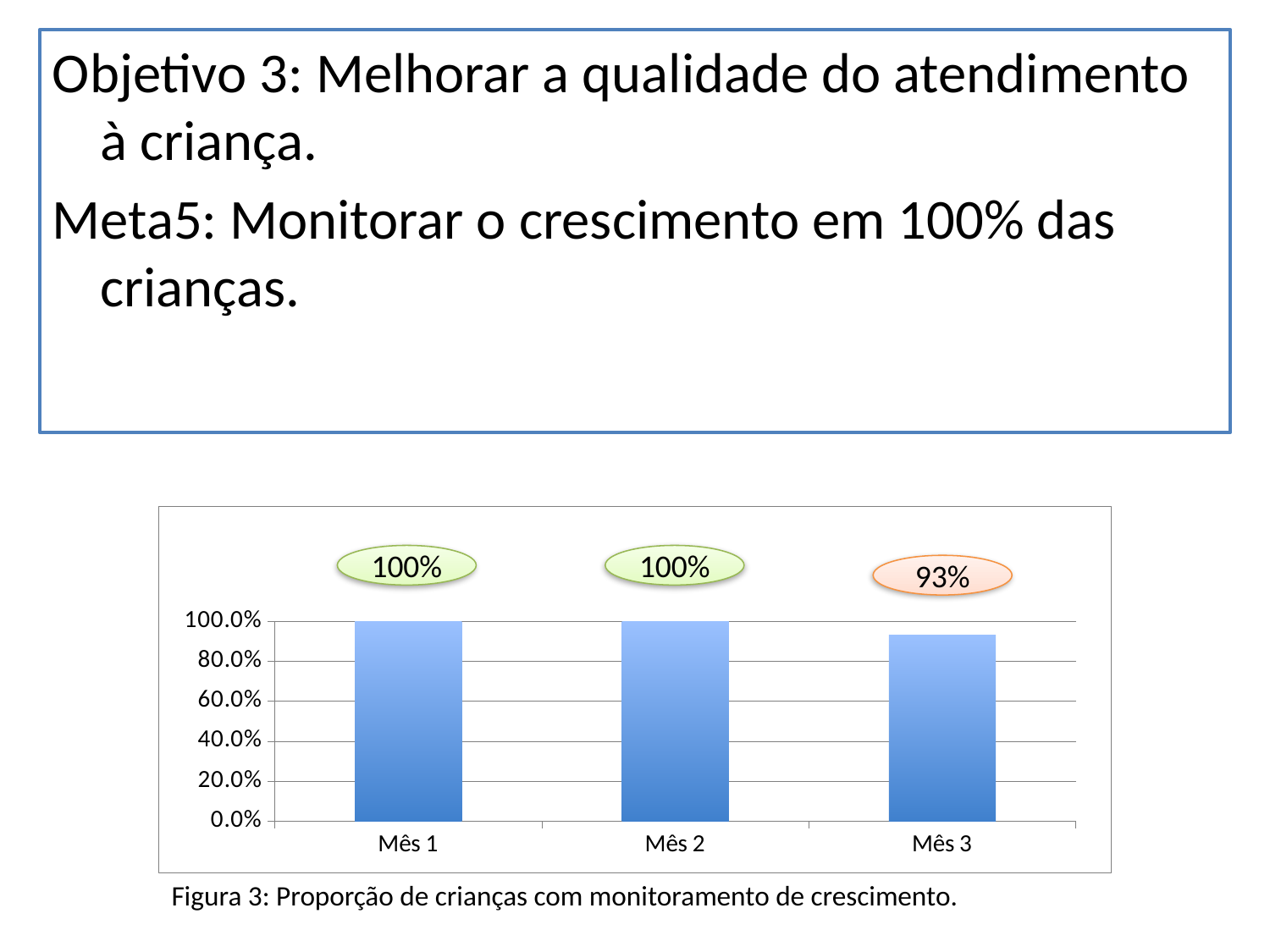
What is the caption of the figure below the chart? Figura 3: Proporção de crianças com monitoramento de crescimento. What is the highest tick value shown on the y axis? 100.0% How many months are shown on the x axis? 3 What is the value for Mês 3? 93% What is the difference between the values for Mês 1 and Mês 3? 7% What kind of chart is shown? bar chart Is the value for Mês 3 greater or less than 80.0%? greater Do the values rise, fall or stay the same from Mês 2 to Mês 3? fall What is the value for Mês 2? 100% Which is larger, the value for Mês 2 or the value for Mês 3? Mês 2 Which month has the lowest value? Mês 3 What is the value for Mês 1? 100%